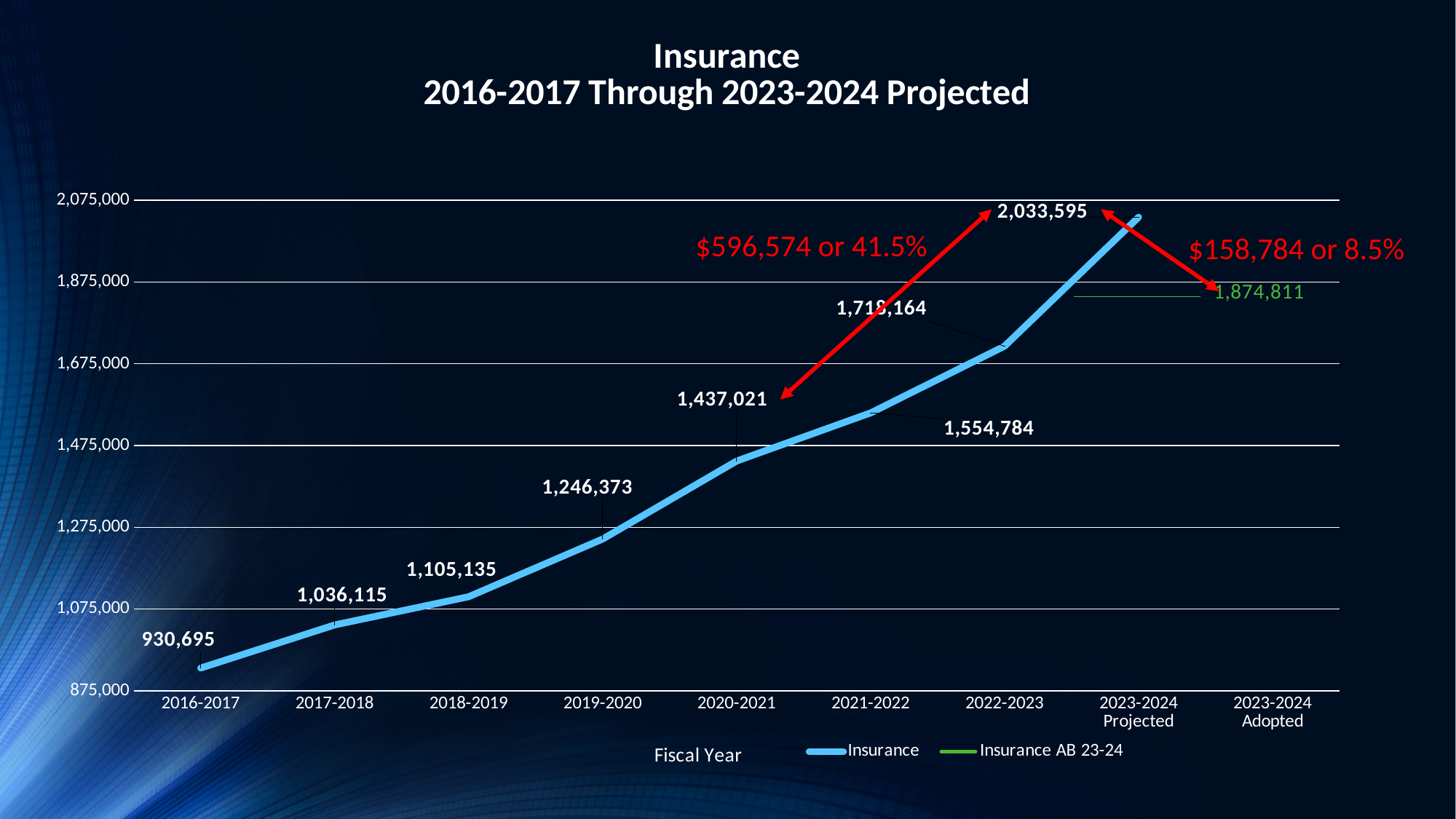
What is the difference between the 2023-2024 Projected value and the 2023-2024 Adopted value? 158,784 Does the Insurance line rise or fall from 2016-2017 to 2023-2024 Projected? rise Which fiscal year has the highest Insurance value? 2023-2024 Projected What is the Insurance value for 2023-2024 Projected? 2,033,595 What kind of chart is shown on the slide? line chart What is the Insurance value for 2019-2020? 1,246,373 Which is larger, the Insurance value for 2020-2021 or for 2021-2022? 2021-2022 Which fiscal year has the lowest Insurance value? 2016-2017 What is the difference between the Insurance values for 2017-2018 and 2016-2017? 105,420 What is the Insurance value for 2016-2017? 930,695 What is the value shown for 2023-2024 Adopted? 1,874,811 How many series does the legend list? 2